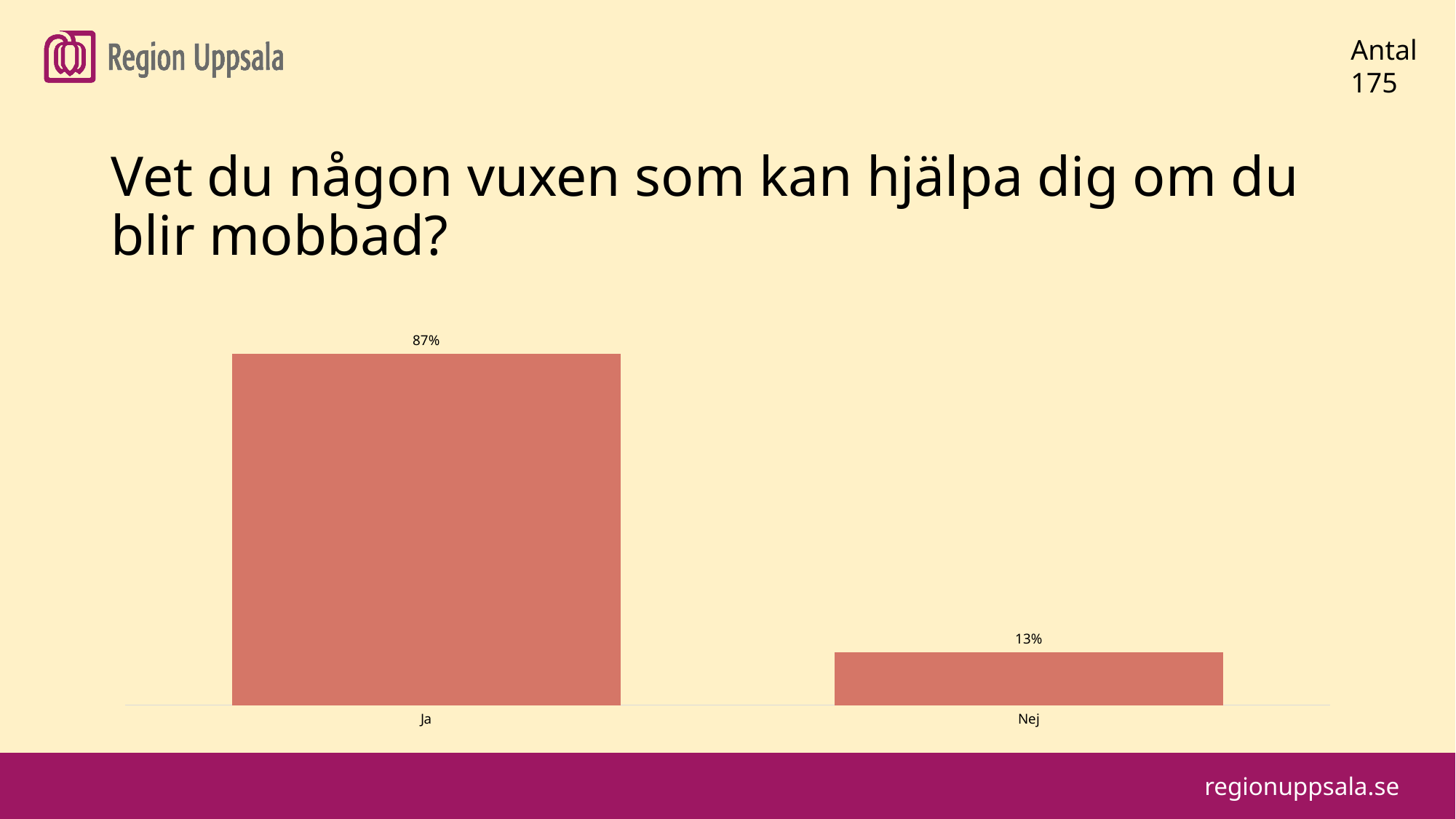
What is the value for Ja? 87% What is the difference between the values for Ja and Nej? 74% How many categories are shown in the chart? 2 What is the total of the values for Ja and Nej? 100% What number is shown under "Antal" in the top right corner of the slide? 175 Which category has the lowest value? Nej Which is larger, the value for Ja or the value for Nej? Ja What kind of chart is shown on the slide? Bar chart What is the title of the slide above the chart? Vet du någon vuxen som kan hjälpa dig om du blir mobbad? What is the value for Nej? 13% Which category has the highest value? Ja